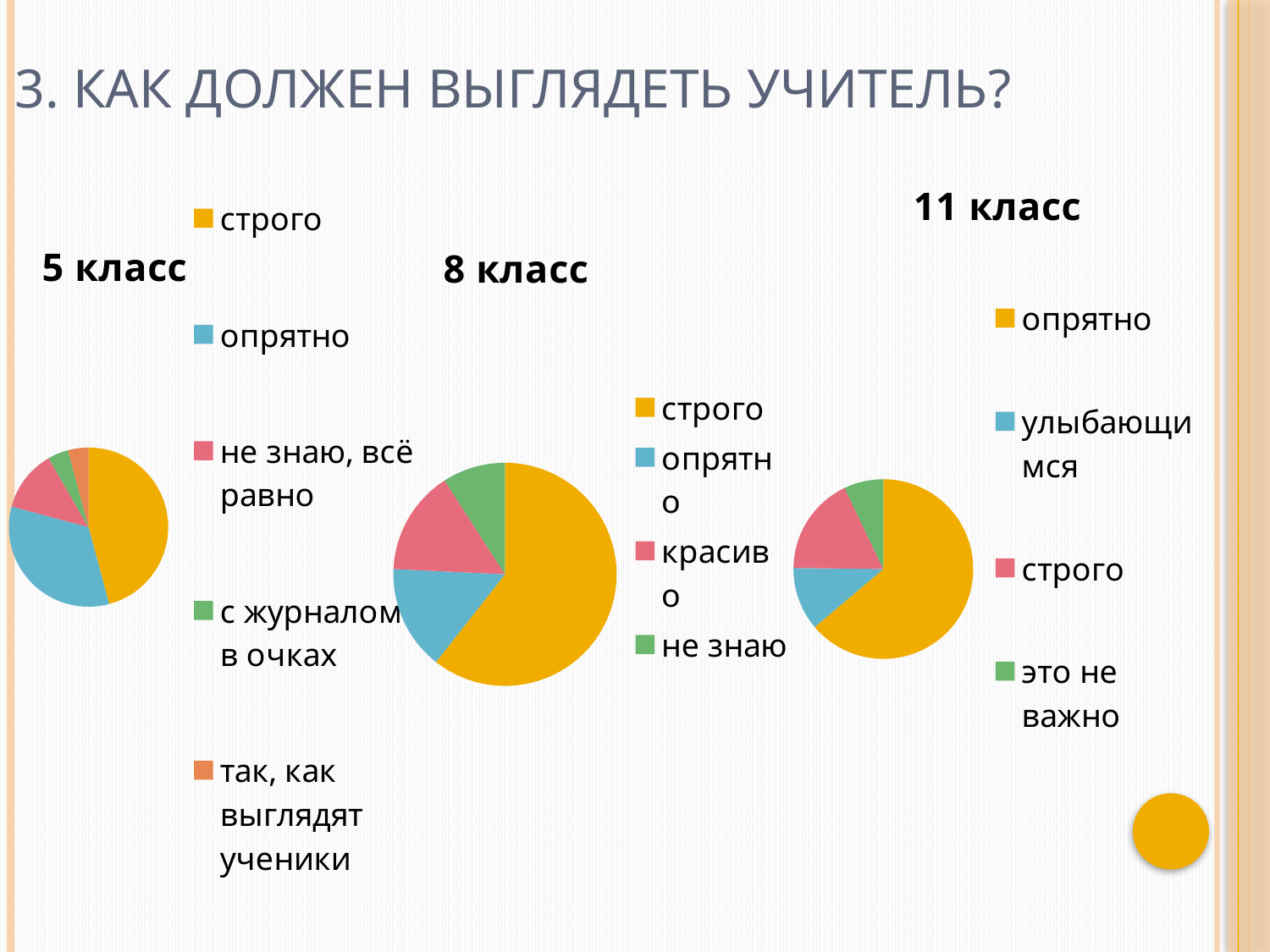
In the "11 класс" chart, how many categories does the legend list? 4 In the "5 класс" chart, which slice is larger: "строго" or "опрятно"? строго In the "11 класс" chart, which category has the largest slice? опрятно In the "8 класс" chart, which category has the largest slice? строго What kind of chart is used for the "5 класс" chart? pie chart In the "8 класс" chart, how many categories does the legend list? 4 In the "11 класс" chart, which colour represents "улыбающимся"? blue In the "8 класс" chart, which category has the smallest slice? не знаю How many charts are shown on the slide? 3 In the "11 класс" chart, which category has the smallest slice? это не важно In the "5 класс" chart, which category has the largest slice? строго